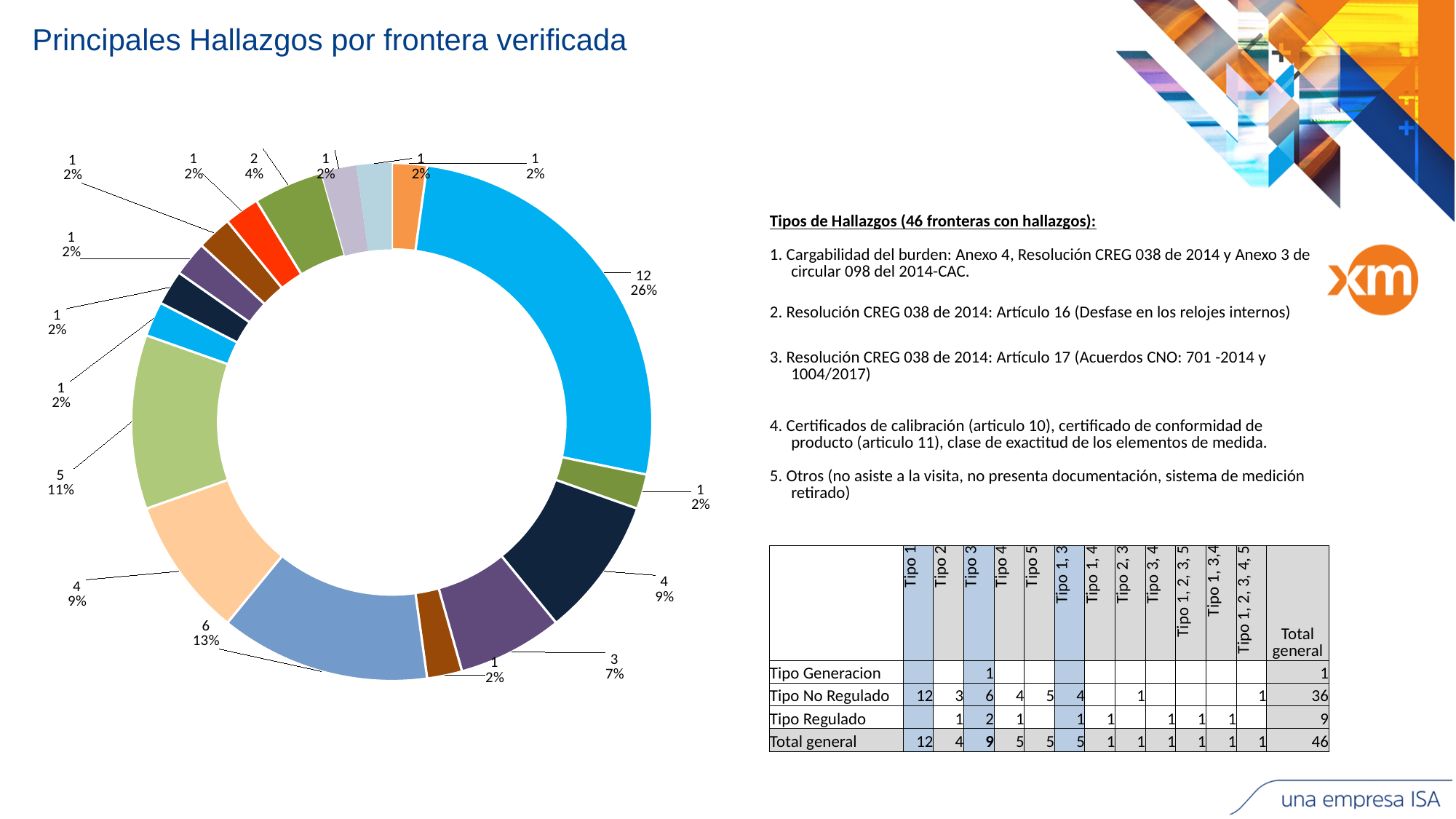
What is the difference between the largest slice (12) and the second-largest slice (6) in the donut chart? 6 What percentage share is shown for the slice with value 6? 13% What percentage share is shown for the slices with value 1? 2% What percentage share does the largest slice of the donut chart represent? 26% What is the value of the largest slice in the donut chart? 12 What kind of chart is shown on the left of the slide? Pie (donut) chart How many slices does the donut chart have? 17 What is the value of the second-largest slice in the donut chart? 6 What is the smallest value shown on any slice of the donut chart? 1 Does the donut chart display a legend? No How many slices in the donut chart have a value of 1? 10